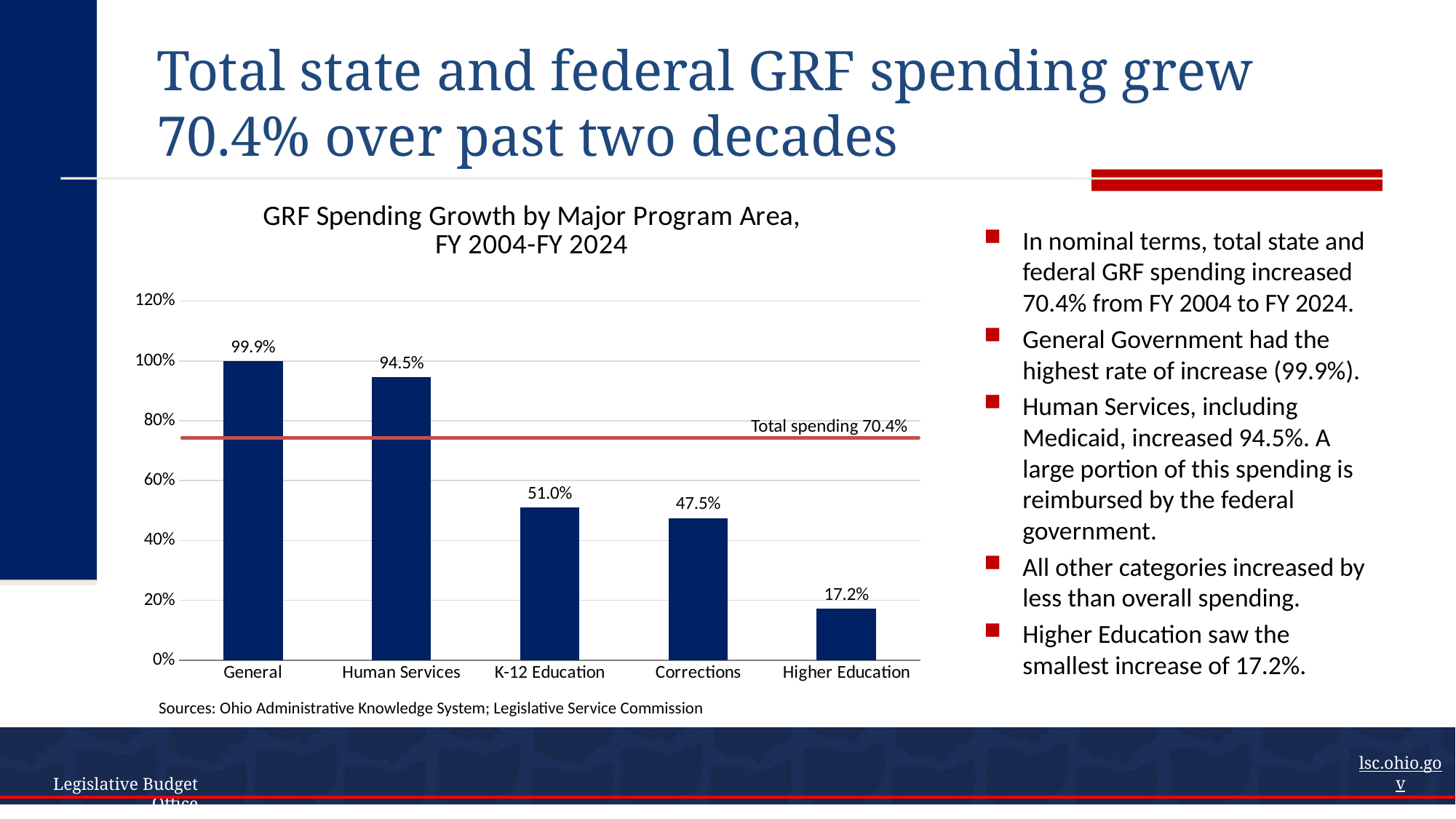
What value does the horizontal red reference line in the chart represent? Total spending 70.4% How many program areas are shown in the chart? 5 Which program area has the highest spending growth? General What is the GRF spending growth value for K-12 Education? 51.0% What is the GRF spending growth value for General? 99.9% What kind of chart is shown on the slide? bar chart What is the difference between the growth for General and Human Services? 5.4% What is the GRF spending growth value for Corrections? 47.5% Which is larger, the growth for K-12 Education or Corrections? K-12 Education Is the value for Higher Education greater or less than 20%? less What is the GRF spending growth value for Human Services? 94.5% Which program area has the lowest spending growth? Higher Education